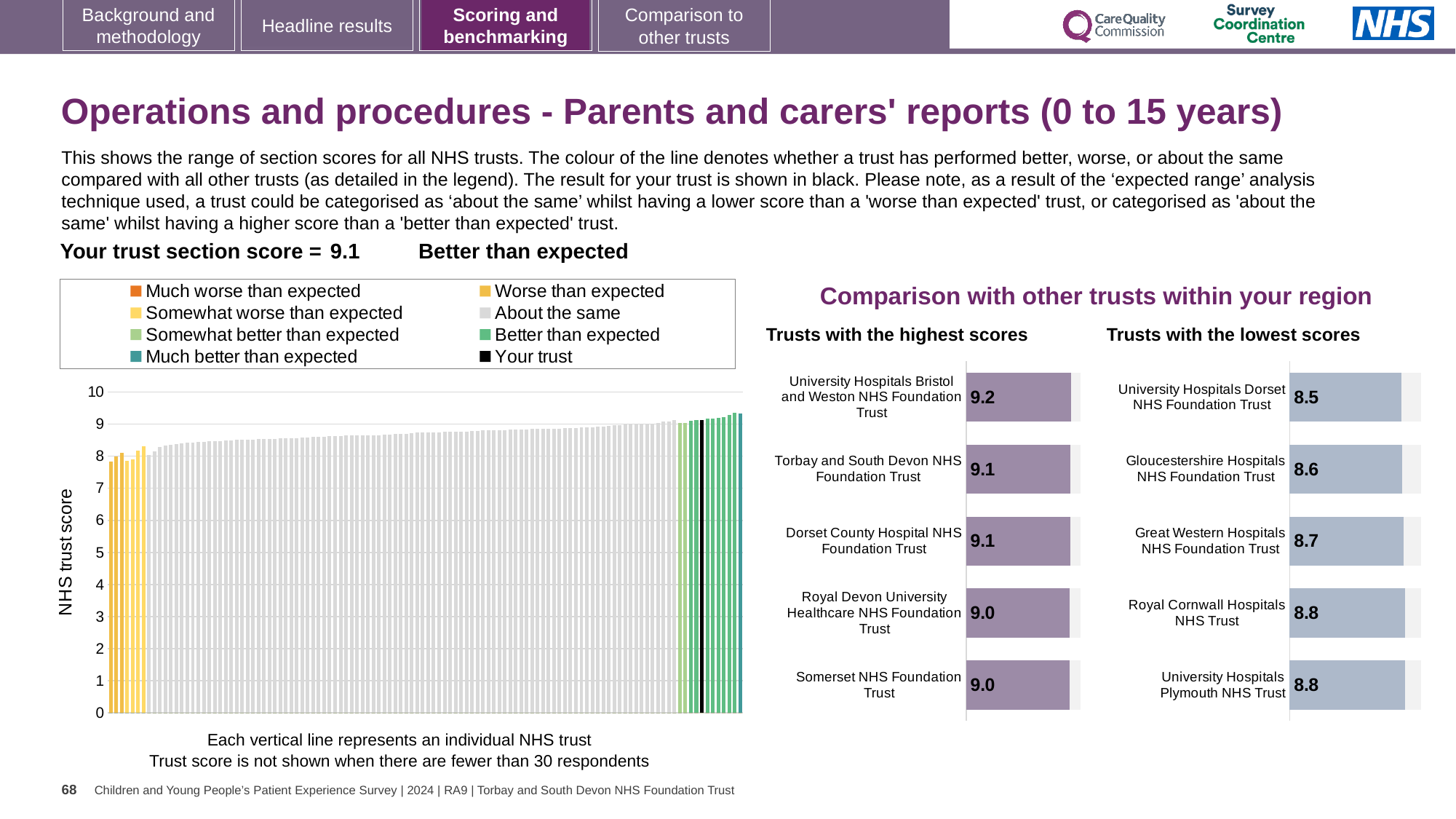
In the 'Trusts with the lowest scores' chart, what is the score for Great Western Hospitals NHS Foundation Trust? 8.7 In the 'Trusts with the highest scores' chart, which trust has the highest score? University Hospitals Bristol and Weston NHS Foundation Trust In the 'Trusts with the lowest scores' chart, what is the difference between the scores of University Hospitals Plymouth NHS Trust and University Hospitals Dorset NHS Foundation Trust? 0.3 In the 'Trusts with the lowest scores' chart, which trust has the lowest score? University Hospitals Dorset NHS Foundation Trust In the 'Trusts with the highest scores' chart, what is the score for Somerset NHS Foundation Trust? 9.0 In the 'Trusts with the highest scores' chart, how many trusts are listed? 5 In the large chart on the left, do the trust scores rise or fall from left to right? Rise In the 'Trusts with the lowest scores' chart, which has the larger score: Gloucestershire Hospitals NHS Foundation Trust or Royal Cornwall Hospitals NHS Trust? Royal Cornwall Hospitals NHS Trust What kind of chart is the large chart on the left showing NHS trust scores? Bar chart In the 'Trusts with the highest scores' chart, what is the score for University Hospitals Bristol and Weston NHS Foundation Trust? 9.2 In the 'Trusts with the highest scores' chart, what is the difference between the scores of University Hospitals Bristol and Weston NHS Foundation Trust and Royal Devon University Healthcare NHS Foundation Trust? 0.2 How many entries does the legend above the large chart on the left list? 8